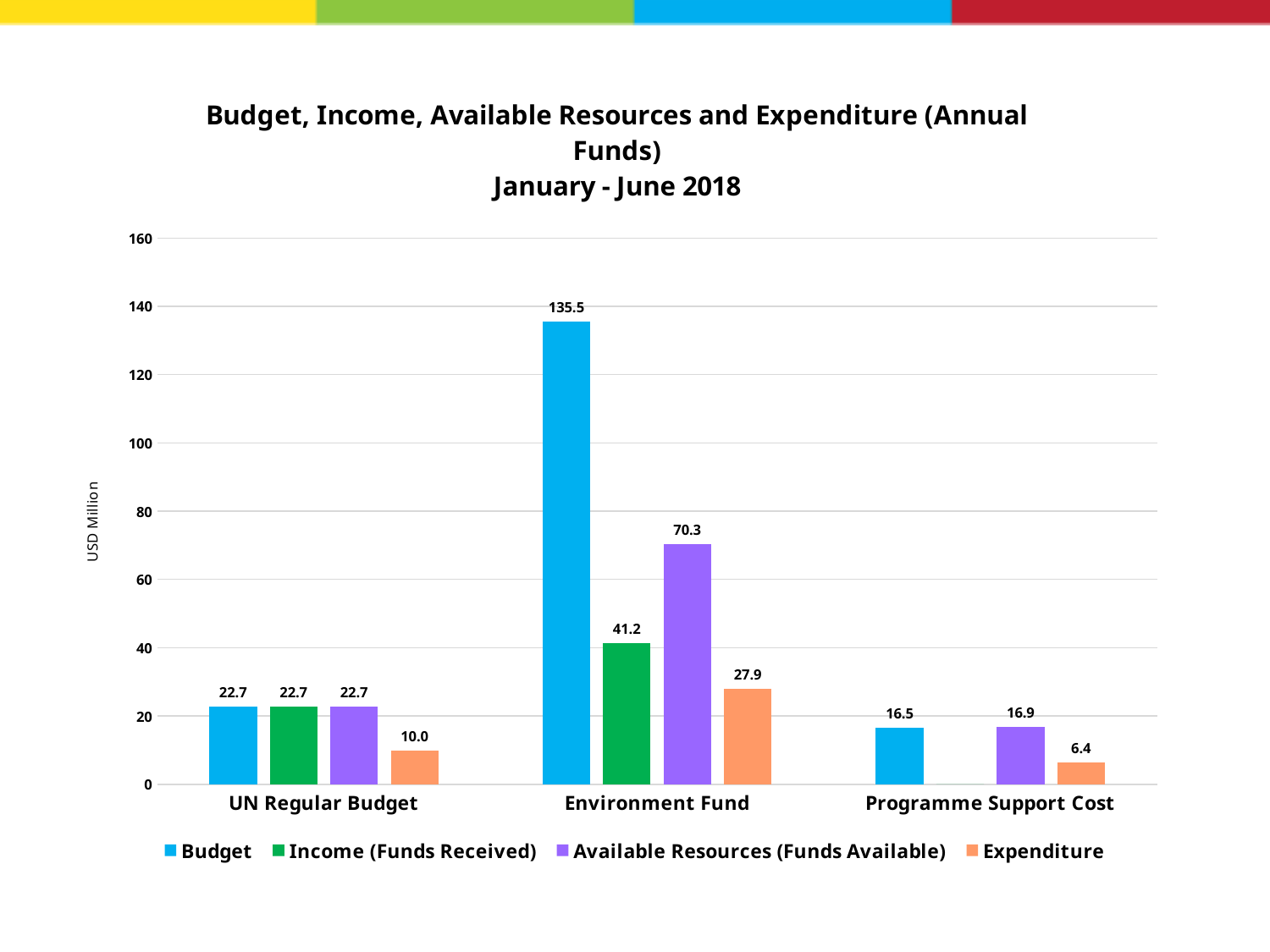
Which is larger for the Environment Fund: Income (Funds Received) or Available Resources (Funds Available)? Available Resources (Funds Available) How many series does the legend list? 4 What is the Budget value for the Environment Fund? 135.5 What is the difference between the Budget and the Available Resources (Funds Available) for the Environment Fund? 65.2 What is the Income (Funds Received) value for the Environment Fund? 41.2 How many categories are shown on the x axis? 3 Which category has the lowest Expenditure value? Programme Support Cost What is the Expenditure value for the UN Regular Budget? 10.0 Which category has the highest Budget value? Environment Fund What is the Available Resources (Funds Available) value for Programme Support Cost? 16.9 What kind of chart is shown on the slide? Bar chart What is the label on the vertical axis? USD Million